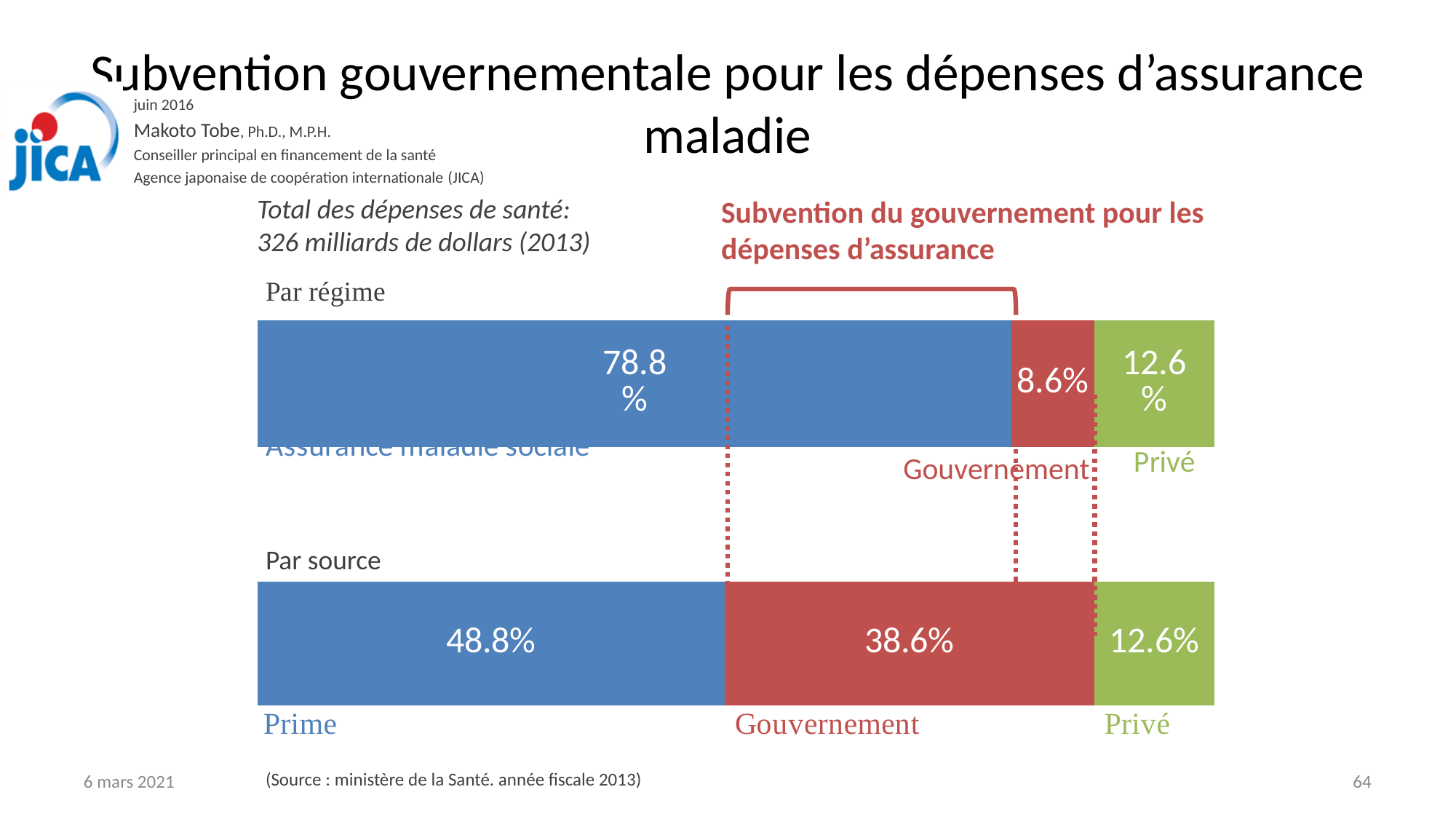
What kind of chart is used to show the 'Par régime' and 'Par source' breakdowns? Stacked bar chart How many segments does the 'Par source' bar have? 3 In the 'Par régime' bar, what is the value for Assurance maladie sociale? 78.8% In the 'Par source' bar, what is the difference between Prime and Gouvernement? 10.2% Which is larger: Gouvernement in the 'Par source' bar or Gouvernement in the 'Par régime' bar? Gouvernement in the 'Par source' bar In the 'Par régime' bar, which segment is the smallest? Gouvernement In the 'Par source' bar, what is the value for Privé? 12.6% In the 'Par régime' bar, which segment is the largest? Assurance maladie sociale In the 'Par source' bar, which segment is the smallest? Privé In the 'Par source' bar, what is the value for Prime? 48.8% In the 'Par source' bar, what is the value for Gouvernement? 38.6% In the 'Par régime' bar, what is the value for Gouvernement? 8.6%